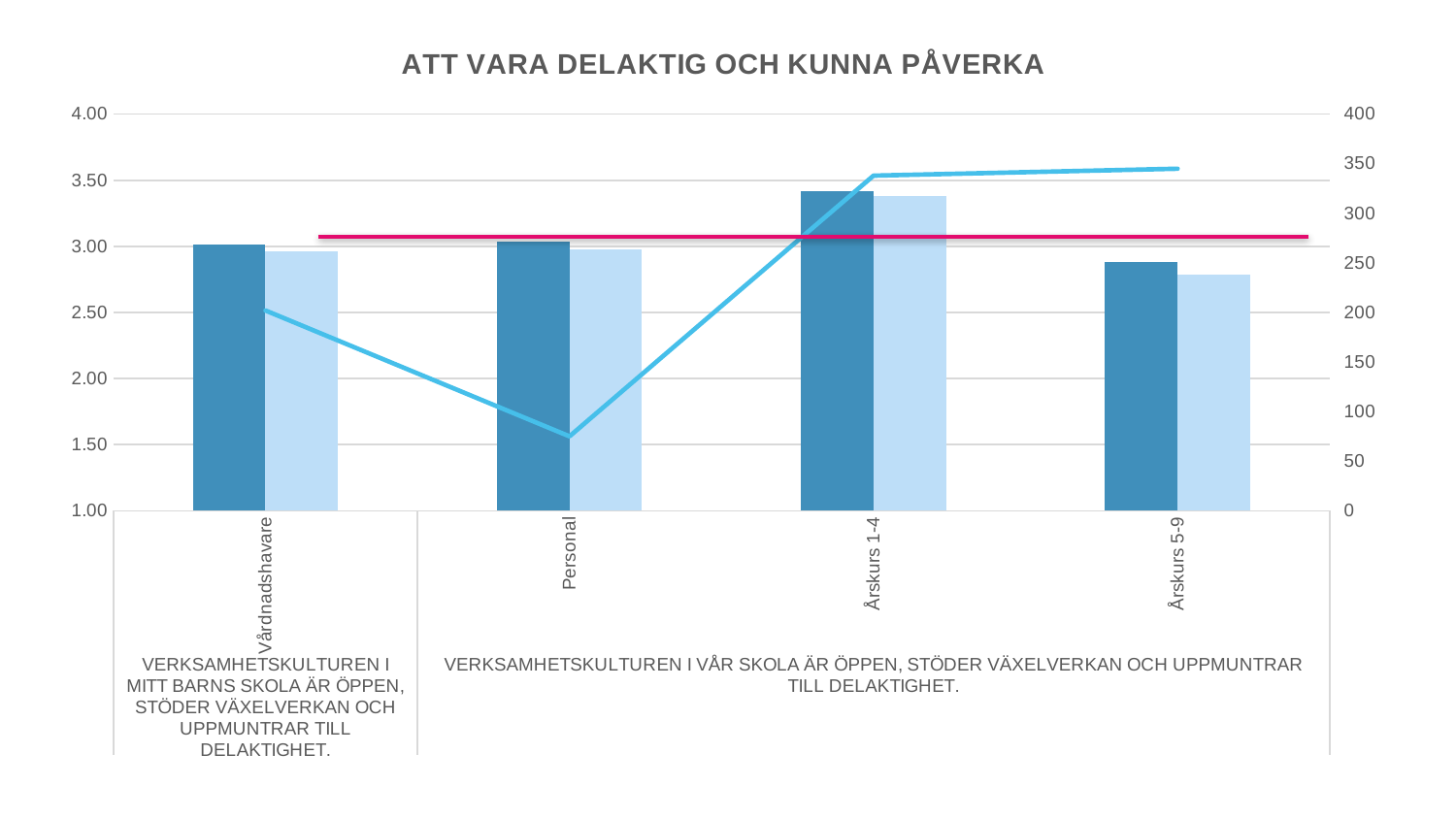
On the right-hand axis, is the line value for Årskurs 5-9 greater or less than 300? greater Is the dark blue bar for Årskurs 1-4 greater or less than 3.00? greater What kind of chart is shown on the slide? Bar chart with a line Which category has the lowest dark blue bar? Årskurs 5-9 Which category has the highest dark blue bar? Årskurs 1-4 Is the light blue bar for Årskurs 5-9 greater or less than 3.00? less Which is larger, the dark blue bar for Årskurs 1-4 or the dark blue bar for Årskurs 5-9? Årskurs 1-4 What is the title of the chart? ATT VARA DELAKTIG OCH KUNNA PÅVERKA How many categories are shown along the x axis? 4 Does the light blue line rise or fall from Personal to Årskurs 1-4? rise